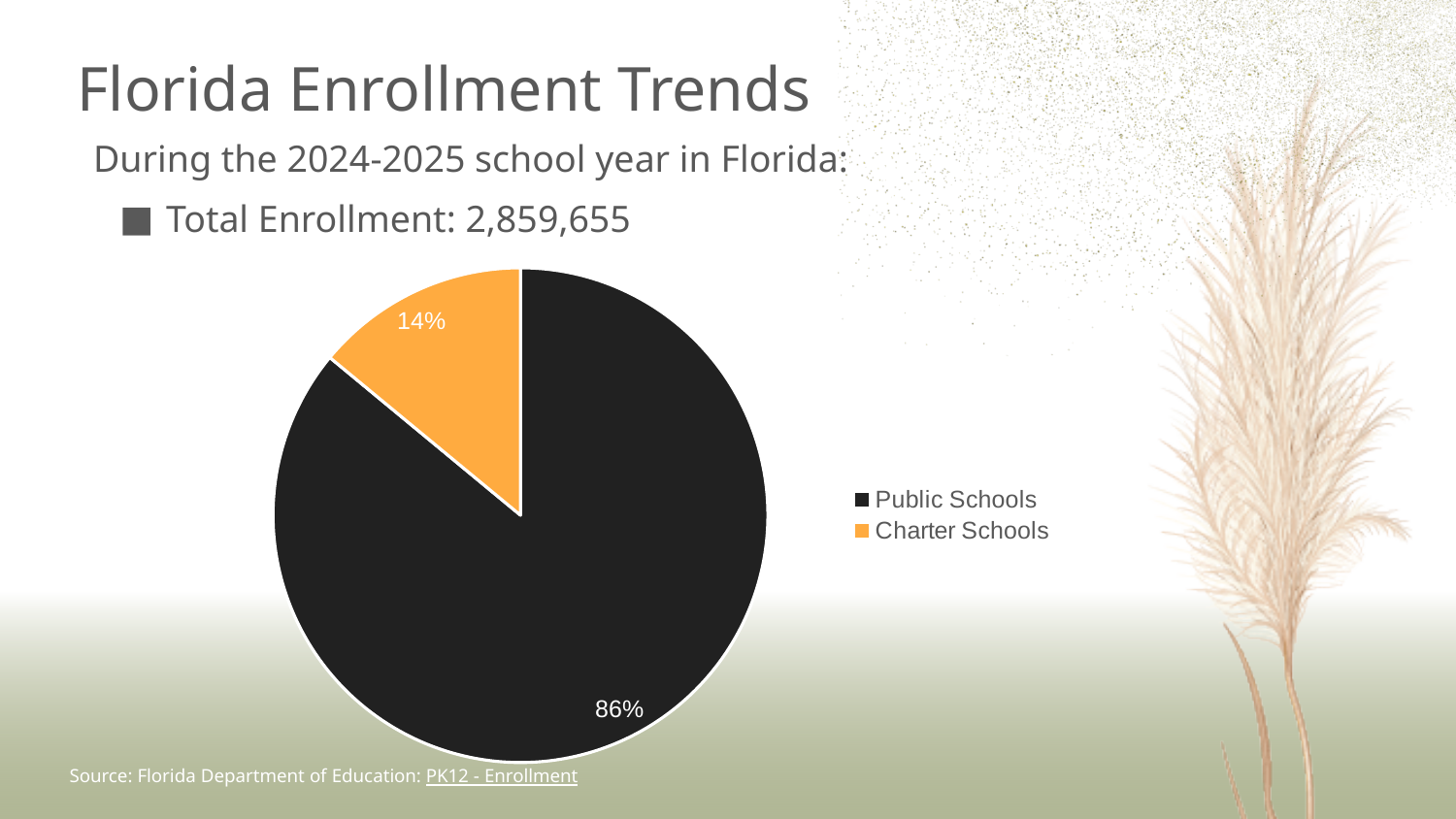
How many entries does the legend list? 2 Which is larger, the Public Schools slice or the Charter Schools slice? Public Schools What is the difference in percentage points between the Public Schools share and the Charter Schools share? 72 What colour is the Public Schools slice? black Which slice of the pie is the smallest? Charter Schools Which slice of the pie is the largest? Public Schools What share of the pie is Charter Schools? 14% How many slices does the pie chart have? 2 What share of the pie is Public Schools? 86% What kind of chart is shown on the slide? pie chart What colour is the Charter Schools slice? orange